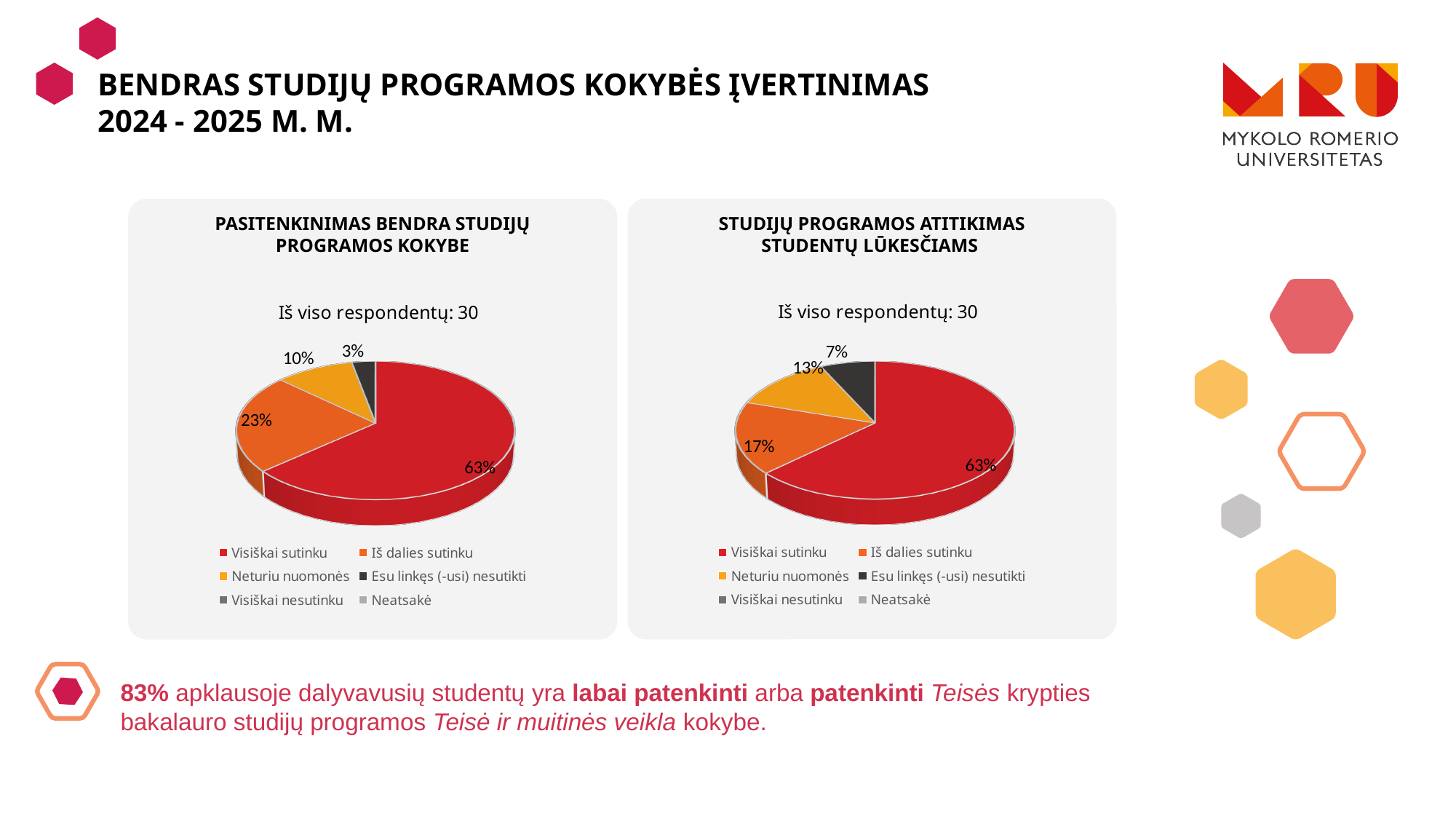
How many respondents are reported for the chart titled 'STUDIJŲ PROGRAMOS ATITIKIMAS STUDENTŲ LŪKESČIAMS'? 30 In the chart titled 'STUDIJŲ PROGRAMOS ATITIKIMAS STUDENTŲ LŪKESČIAMS', what share of respondents answered 'Iš dalies sutinku'? 17% In the chart titled 'PASITENKINIMAS BENDRA STUDIJŲ PROGRAMOS KOKYBE', what share of respondents answered 'Neturiu nuomonės'? 10% In the chart titled 'PASITENKINIMAS BENDRA STUDIJŲ PROGRAMOS KOKYBE', which is larger: the 'Iš dalies sutinku' slice or the 'Neturiu nuomonės' slice? Iš dalies sutinku In the chart titled 'PASITENKINIMAS BENDRA STUDIJŲ PROGRAMOS KOKYBE', what share of respondents answered 'Visiškai sutinku'? 63% How many entries does the legend of the chart titled 'PASITENKINIMAS BENDRA STUDIJŲ PROGRAMOS KOKYBE' list? 6 In the chart titled 'PASITENKINIMAS BENDRA STUDIJŲ PROGRAMOS KOKYBE', which answer has the smallest slice? Esu linkęs (-usi) nesutikti What kind of chart is used in the chart titled 'STUDIJŲ PROGRAMOS ATITIKIMAS STUDENTŲ LŪKESČIAMS'? Pie chart In the chart titled 'STUDIJŲ PROGRAMOS ATITIKIMAS STUDENTŲ LŪKESČIAMS', which answer has the largest slice? Visiškai sutinku In the chart titled 'STUDIJŲ PROGRAMOS ATITIKIMAS STUDENTŲ LŪKESČIAMS', what is the difference between the 'Iš dalies sutinku' and 'Neturiu nuomonės' shares? 4% In the chart titled 'STUDIJŲ PROGRAMOS ATITIKIMAS STUDENTŲ LŪKESČIAMS', what share of respondents answered 'Esu linkęs (-usi) nesutikti'? 7% In the chart titled 'PASITENKINIMAS BENDRA STUDIJŲ PROGRAMOS KOKYBE', what share of respondents answered 'Iš dalies sutinku'? 23%